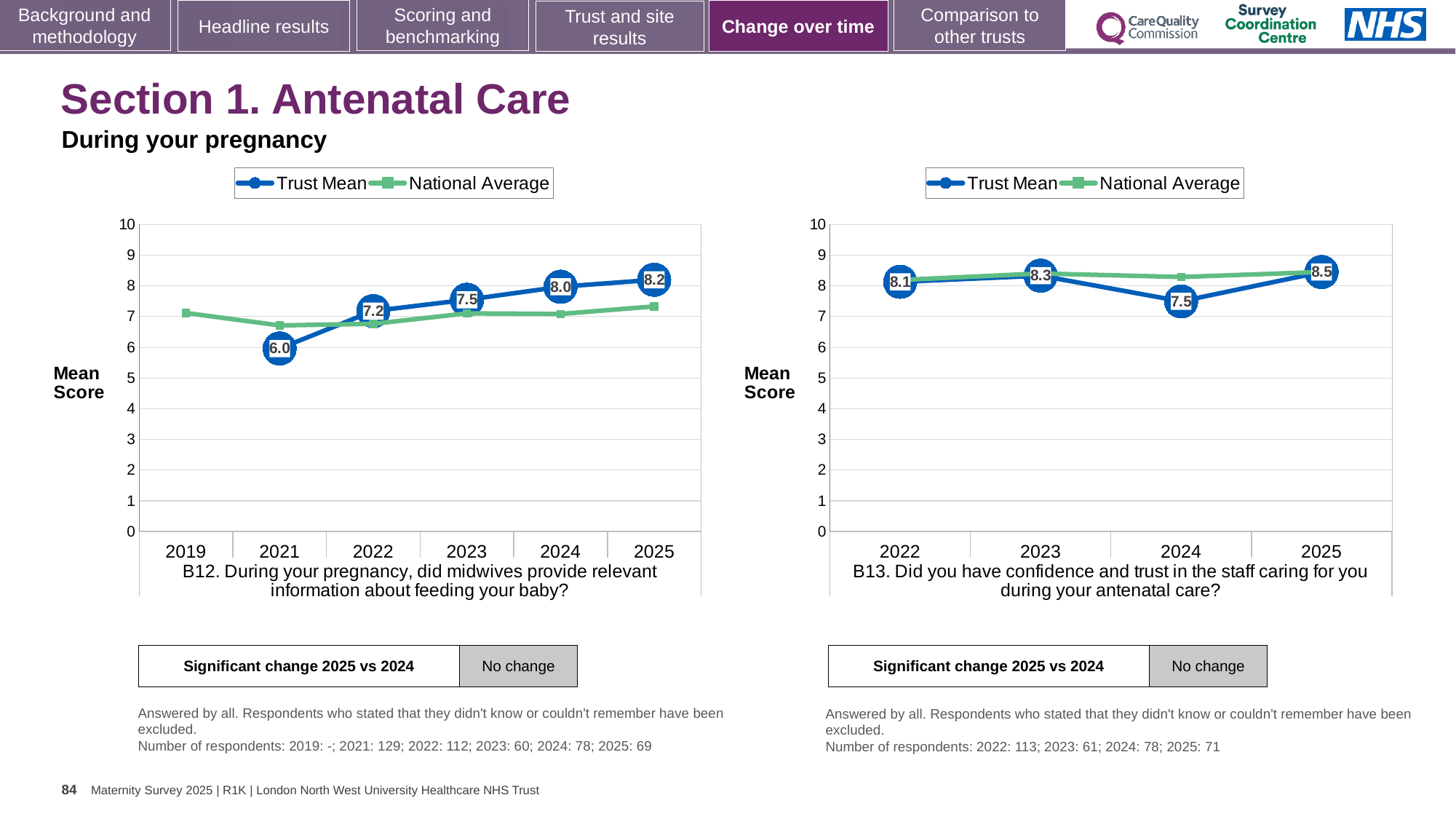
In the B13 chart on the right, what is the Trust Mean for 2024? 7.5 How many years are shown on the x axis of the B13 chart on the right? 4 In the B12 chart on the left, which year has the lowest labelled Trust Mean? 2021 In the B13 chart on the right, which year has the highest Trust Mean? 2025 In the B13 chart on the right, what is the difference between the Trust Mean for 2025 and the Trust Mean for 2024? 1.0 In the B12 chart on the left, does the Trust Mean rise or fall from 2021 to 2025? rise In the B13 chart on the right, is the National Average for 2024 greater or less than 8? greater In the B12 chart on the left, what is the Trust Mean for 2025? 8.2 In the B12 chart on the left, what is the difference between the Trust Mean for 2025 and the Trust Mean for 2021? 2.2 In the B12 chart on the left, what is the Trust Mean for 2021? 6.0 In the B12 chart on the left, is the National Average for 2021 greater or less than 7? less In the B13 chart on the right, is the Trust Mean higher in 2023 or in 2024? 2023